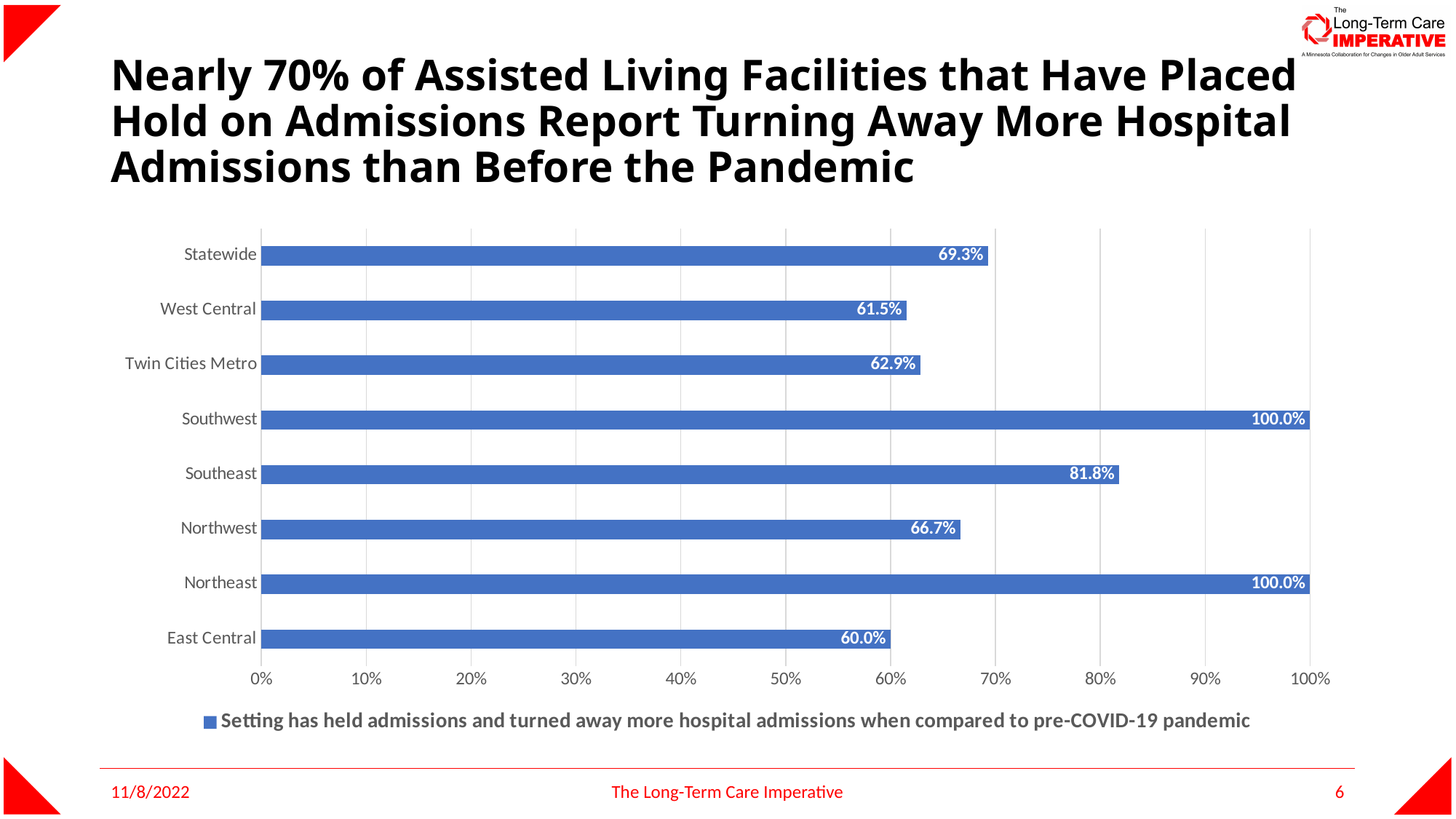
What kind of chart is shown on the slide? Bar chart What is the value for Twin Cities Metro? 62.9% What is the value for East Central? 60.0% Which two regions share the highest value of 100.0%? Southwest and Northeast How many categories are shown on the chart? 8 How many series does the legend list? 1 What is the value for Southeast? 81.8% Which region has the lowest value? East Central What is the difference between the Southeast and West Central values? 20.3% What is the value for Statewide? 69.3% Is the value for Southeast greater or less than 80%? greater Which is larger, the value for Northwest or the value for Twin Cities Metro? Northwest